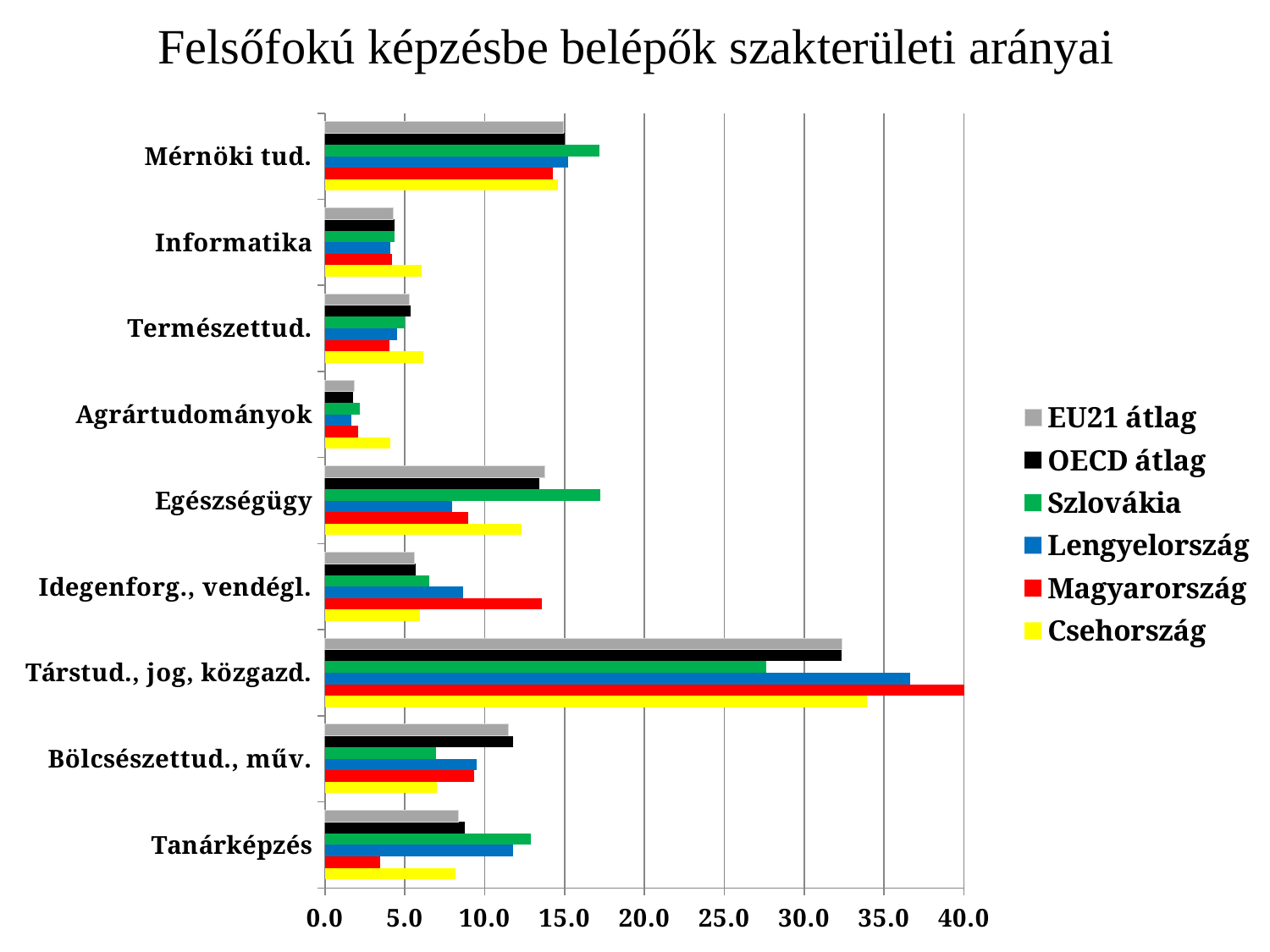
How many categories (fields of study) are shown on the y axis? 9 What is the title of the chart? Felsőfokú képzésbe belépők szakterületi arányai Is the value for Szlovákia in Egészségügy greater or less than 15.0? greater Is the value for Magyarország in Társtud., jog, közgazd. greater or less than 35.0? greater Which series is shown in yellow in the legend? Csehország Is the value for Magyarország in Tanárképzés greater or less than 5.0? less Which category has the highest value for Magyarország? Társtud., jog, közgazd. What kind of chart is shown on the slide? bar chart In Társtud., jog, közgazd., which is larger: the value for Lengyelország or the value for Szlovákia? Lengyelország In Idegenforg., vendégl., which is larger: the value for Magyarország or the value for Csehország? Magyarország How many series does the legend list? 6 Which category has the lowest value for Csehország? Agrártudományok